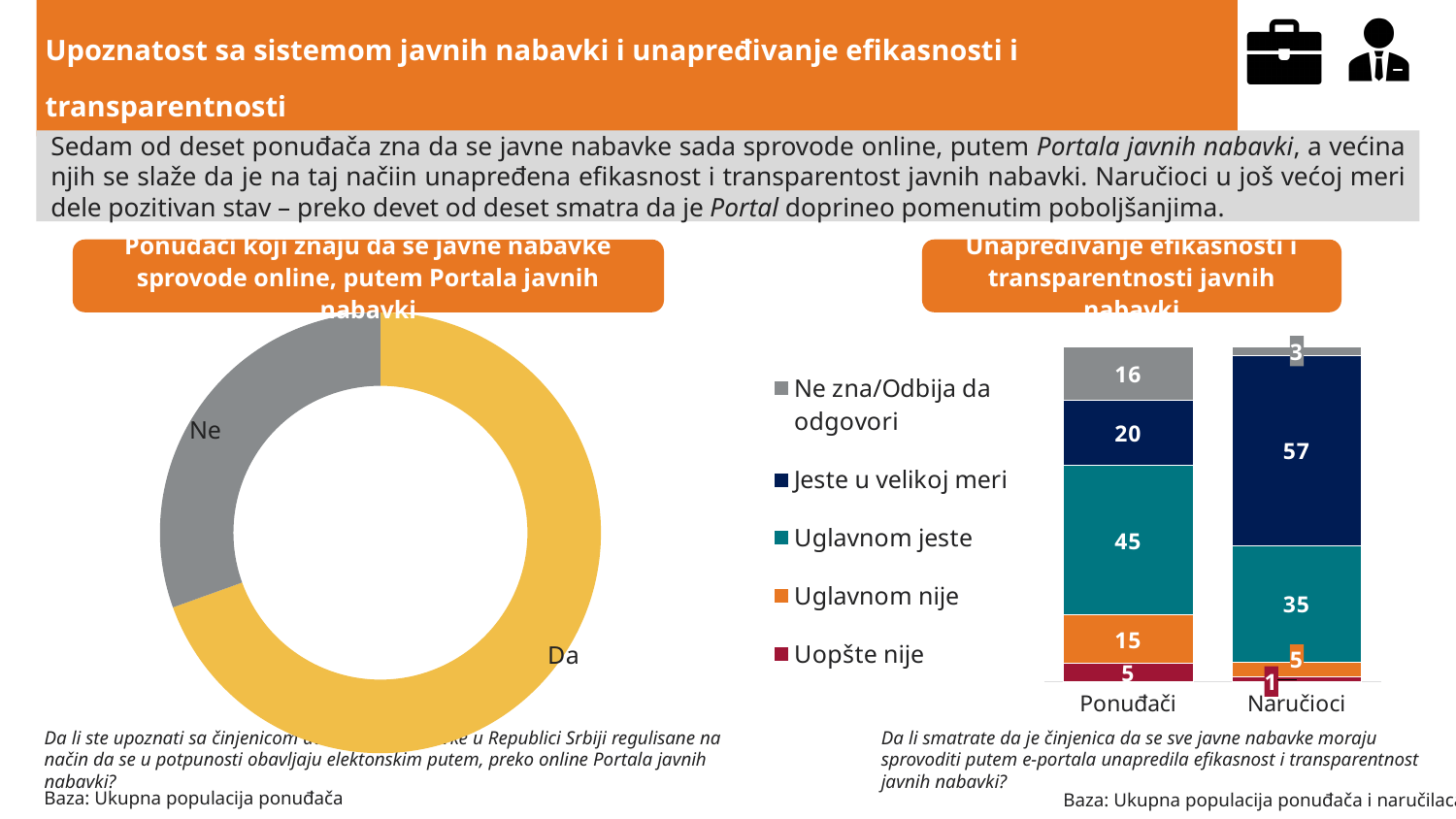
In the right chart, what is the value of Jeste u velikoj meri for Naručioci? 57 In the right chart, what is the value of Ne zna/Odbija da odgovori for Ponuđači? 16 In the right chart, which group has the larger Uglavnom nije value, Ponuđači or Naručioci? Ponuđači In the right chart, what is the difference between the Jeste u velikoj meri values for Naručioci and Ponuđači? 37 What kind of chart is the left chart on the slide (Ponuđači koji znaju da se javne nabavke sprovode online)? doughnut chart How many slices does the left doughnut chart have? 2 How many series does the legend of the right chart list? 5 In the right chart, what is the value of Uglavnom jeste for Ponuđači? 45 What kind of chart is the right chart (Unapređivanje efikasnosti i transparentnosti javnih nabavki)? stacked bar chart In the right chart, what is the value of Uopšte nije for Naručioci? 1 How many categories (bars) are shown on the x axis of the right chart? 2 In the left doughnut chart, which slice is larger, Da or Ne? Da